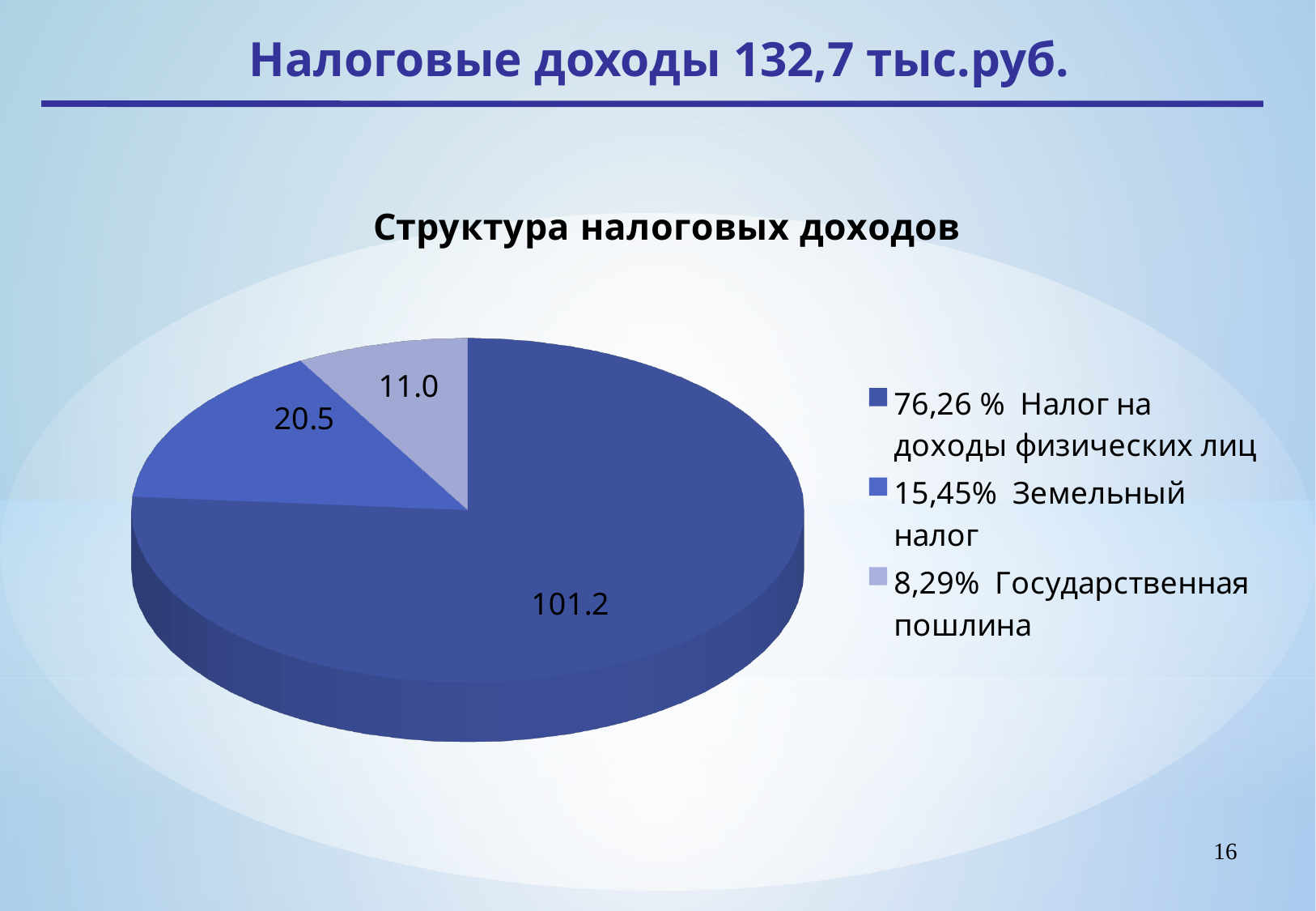
Which category has the largest slice? Налог на доходы физических лиц What share of the pie does Земельный налог represent, according to the legend? 15,45% What is the value for Налог на доходы физических лиц? 101.2 How many slices does the pie chart have? 3 What is the value for Земельный налог? 20.5 What is the value for Государственная пошлина? 11.0 What is the difference between the values for Земельный налог and Государственная пошлина? 9.5 What is the chart's title? Структура налоговых доходов What is the difference between the values for Налог на доходы физических лиц and Земельный налог? 80.7 Which category has the smallest slice? Государственная пошлина What kind of chart is shown on the slide? pie chart Which is larger, the value for Земельный налог or the value for Государственная пошлина? Земельный налог